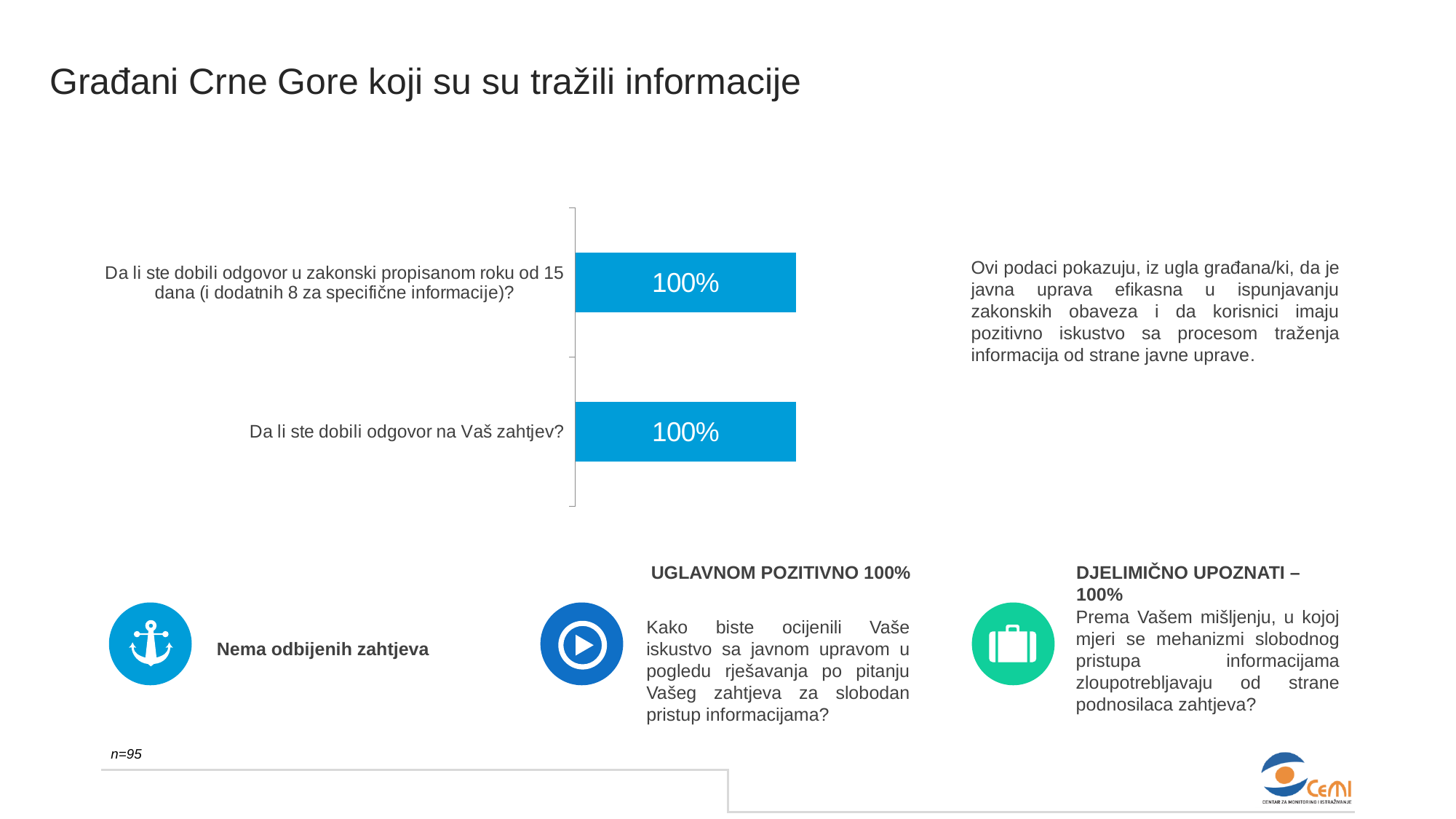
Is the value for "Da li ste dobili odgovor na Vaš zahtjev?" greater or less than 50%? greater Do the two bars in the chart have the same value? Yes, both are 100% How many categories (bars) does the chart show? 2 What is the sample size (n) noted on the slide? n=95 What colour are the bars in the chart? Blue What is the value for "Da li ste dobili odgovor na Vaš zahtjev?"? 100% What is the value for "Da li ste dobili odgovor u zakonski propisanom roku od 15 dana (i dodatnih 8 za specifične informacije)?"? 100% What is the difference between the values of the two bars in the chart? 0% What kind of chart is shown on the slide? Bar chart